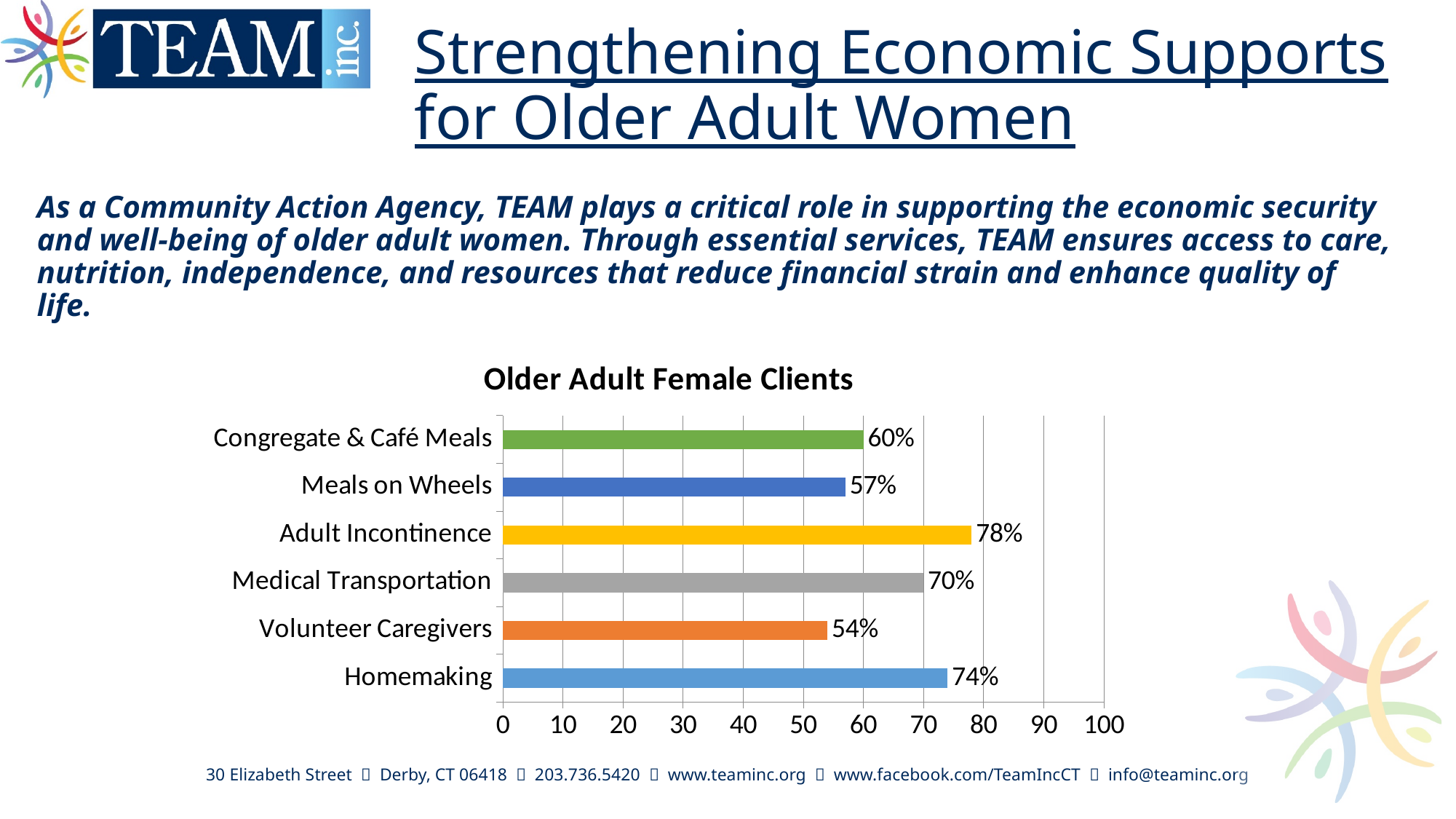
What is the value for Homemaking in the Older Adult Female Clients chart? 74% How many categories are shown in the Older Adult Female Clients chart? 6 What is the value for Adult Incontinence in the Older Adult Female Clients chart? 78% Is the value for Volunteer Caregivers greater or less than 60? less What kind of chart is shown on the slide? bar chart Which category has the lowest value in the Older Adult Female Clients chart? Volunteer Caregivers Which category has the highest value in the Older Adult Female Clients chart? Adult Incontinence What is the value for Meals on Wheels in the Older Adult Female Clients chart? 57% What is the title of the chart on the slide? Older Adult Female Clients What colour is the bar for Adult Incontinence? yellow Which is larger, the value for Homemaking or the value for Medical Transportation? Homemaking What is the difference between the values for Medical Transportation and Congregate & Café Meals? 10%